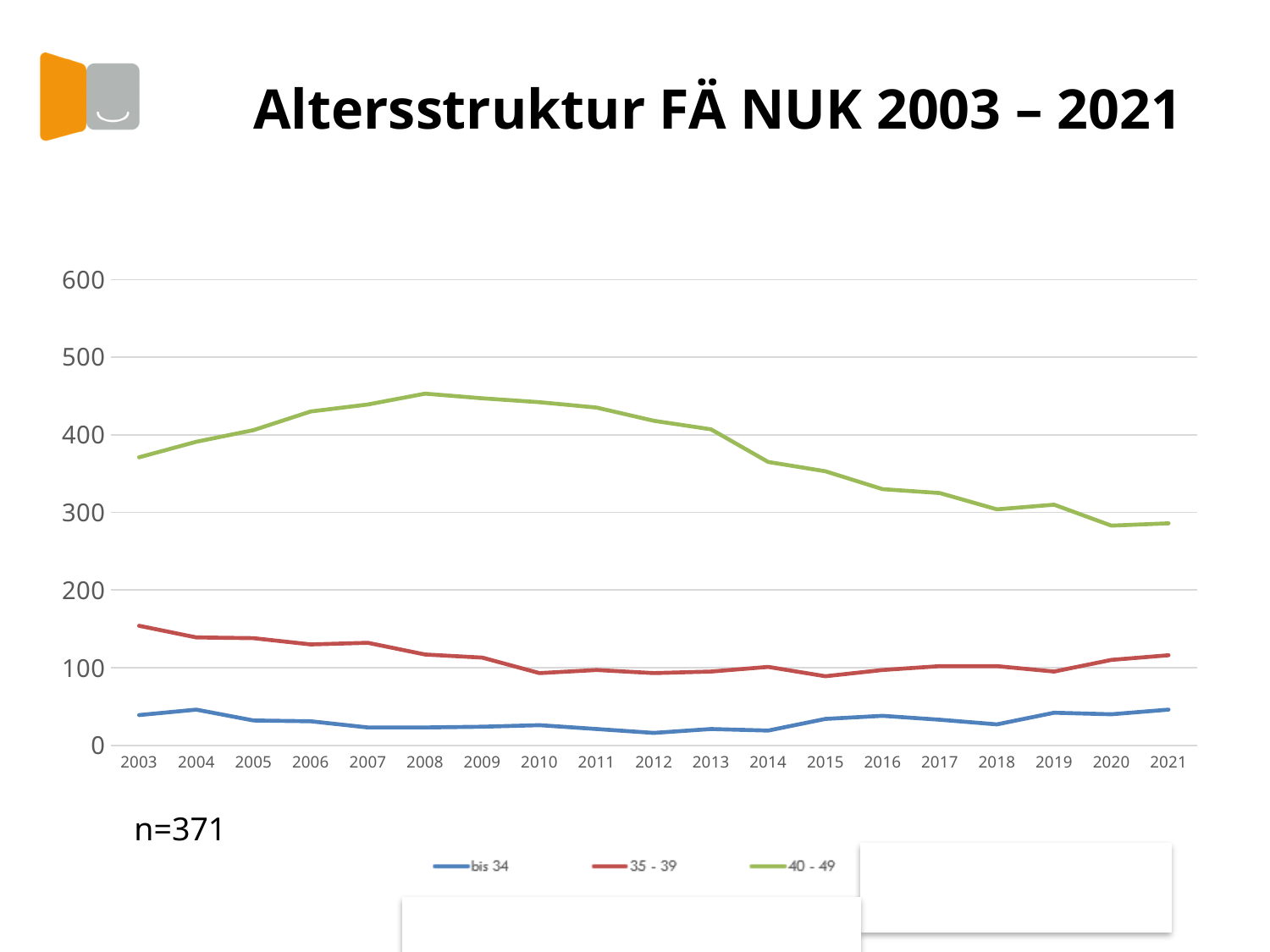
Is the value for 35 - 39 in 2003 greater or less than 100? greater Which series has the higher value in 2010, 35 - 39 or 40 - 49? 40 - 49 Does the 40 - 49 series rise or fall from 2008 to 2021? fall What kind of chart is shown on the slide? line chart In which year does the 40 - 49 series reach its highest value? 2008 Is the value for 40 - 49 in 2021 greater or less than 300? less In which year does the 40 - 49 series reach its lowest value? 2020 What is the title of the chart? Altersstruktur FÄ NUK 2003 – 2021 Is the value for 40 - 49 in 2008 greater or less than 400? greater How many series does the legend list? 3 How many years are plotted along the x axis? 19 In which year does the 35 - 39 series reach its highest value? 2003